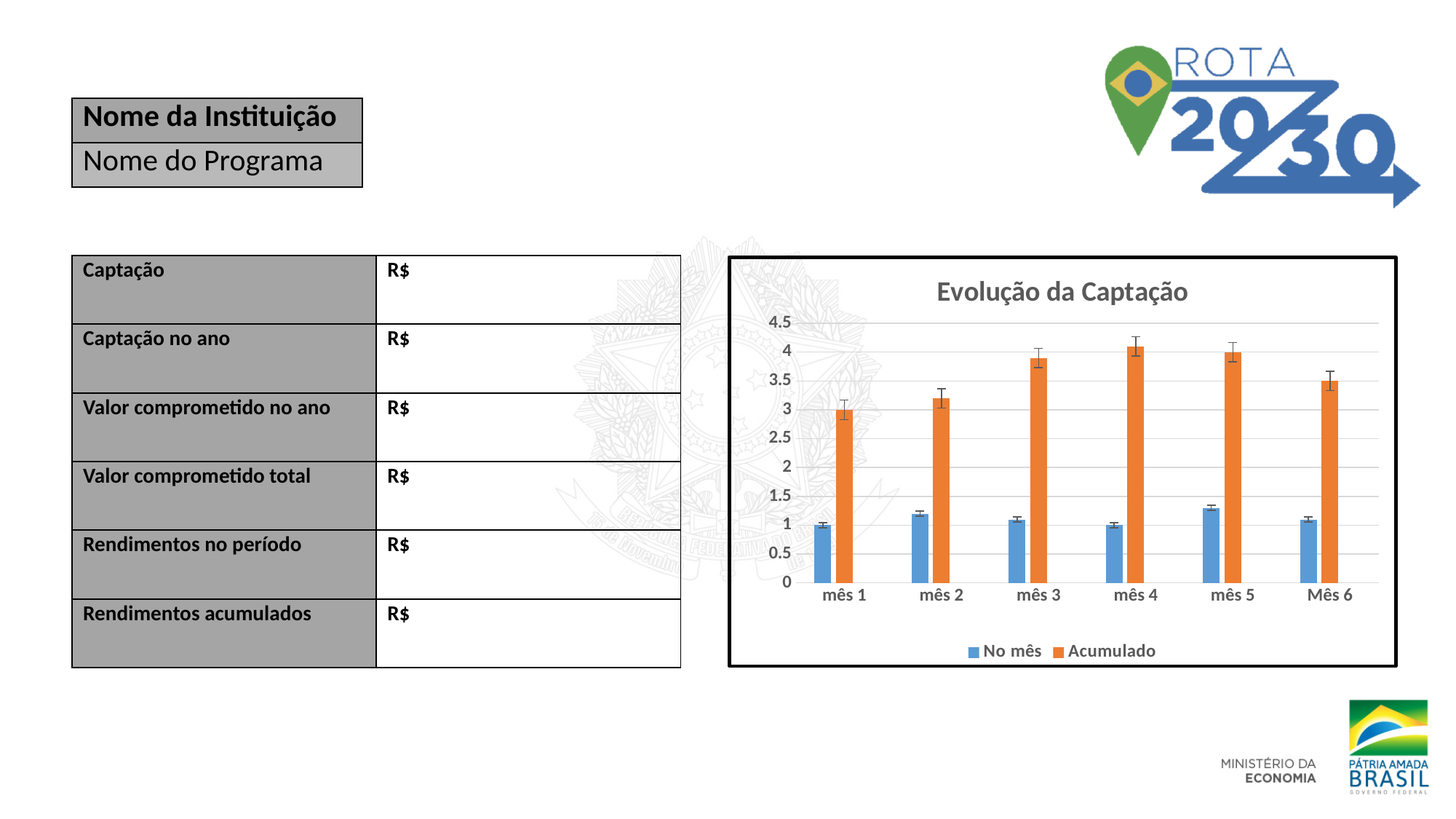
What kind of chart is shown on the slide? bar chart Does the Acumulado series rise or fall from mês 1 to mês 4? rise What are the two series named in the chart legend? No mês and Acumulado Is the Acumulado value for mês 4 greater or less than 3.5? greater Which month has the larger Acumulado value: mês 1 or mês 3? mês 3 Is the Acumulado value for mês 1 greater or less than 3.5? less How many series does the chart legend list? 2 What is the title of the chart? Evolução da Captação Is the No mês value for mês 1 greater or less than 1.5? less Which is larger in mês 2: the No mês value or the Acumulado value? Acumulado How many months (categories) are shown on the x axis of the chart? 6